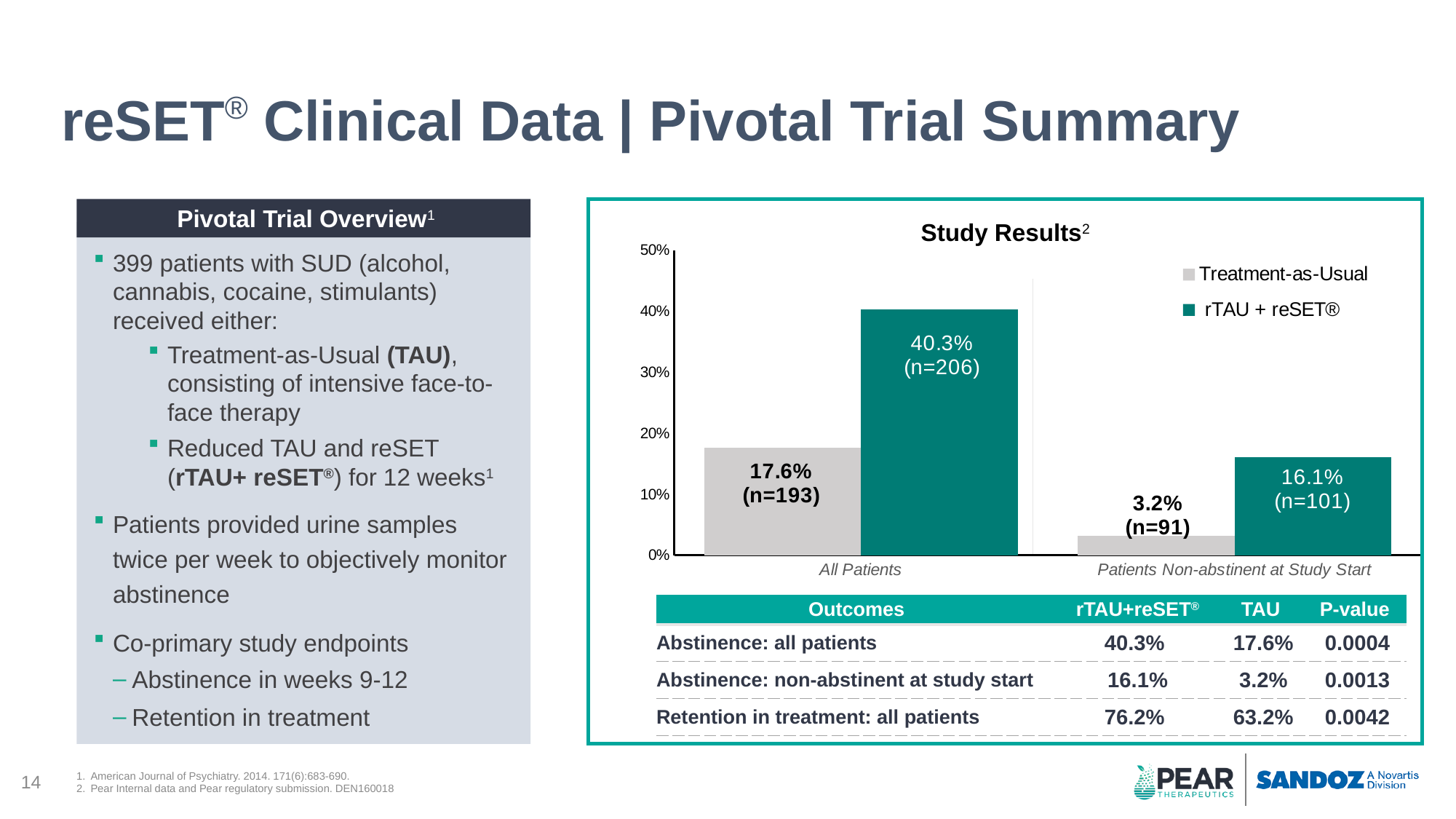
What is the difference between the rTAU + reSET® and Treatment-as-Usual values in the All Patients category? 22.7% Which bar in the chart has the lowest value? Treatment-as-Usual, Patients Non-abstinent at Study Start Which bar in the chart has the highest value? rTAU + reSET®, All Patients How many categories are shown on the x axis of the chart? 2 What is the difference between the rTAU + reSET® and Treatment-as-Usual values in the Patients Non-abstinent at Study Start category? 12.9% What is the value for rTAU + reSET® in the Patients Non-abstinent at Study Start category? 16.1% What kind of chart is shown on the slide? Bar chart What is the value for Treatment-as-Usual in the All Patients category? 17.6% What is the value for Treatment-as-Usual in the Patients Non-abstinent at Study Start category? 3.2% What is the value for rTAU + reSET® in the All Patients category? 40.3% Which is larger: the Treatment-as-Usual value for All Patients or the rTAU + reSET® value for Patients Non-abstinent at Study Start? Treatment-as-Usual value for All Patients How many series does the chart legend list? 2